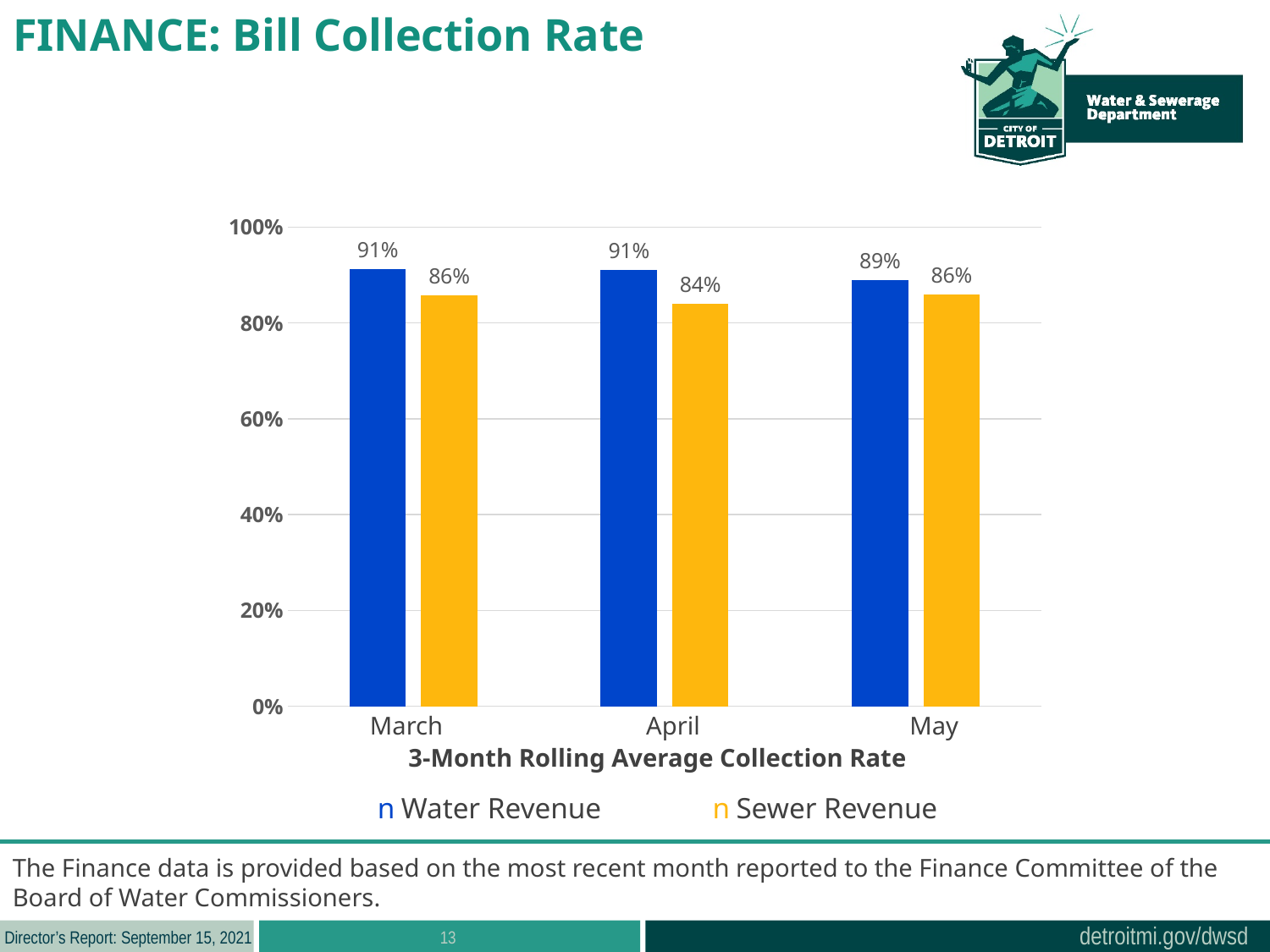
In which month is the Sewer Revenue collection rate lowest? April How many months are shown on the x axis? 3 How many series does the legend list? 2 What is the Sewer Revenue collection rate for April? 84% In which month is the Water Revenue collection rate lowest? May What is the x-axis title of the chart? 3-Month Rolling Average Collection Rate What kind of chart is shown on the slide? Bar chart Which is larger in March, the Water Revenue or the Sewer Revenue collection rate? Water Revenue What is the Sewer Revenue collection rate for May? 86% What is the Water Revenue collection rate for May? 89% What is the difference between the Water Revenue and Sewer Revenue collection rates in April? 7% What is the Water Revenue collection rate for March? 91%